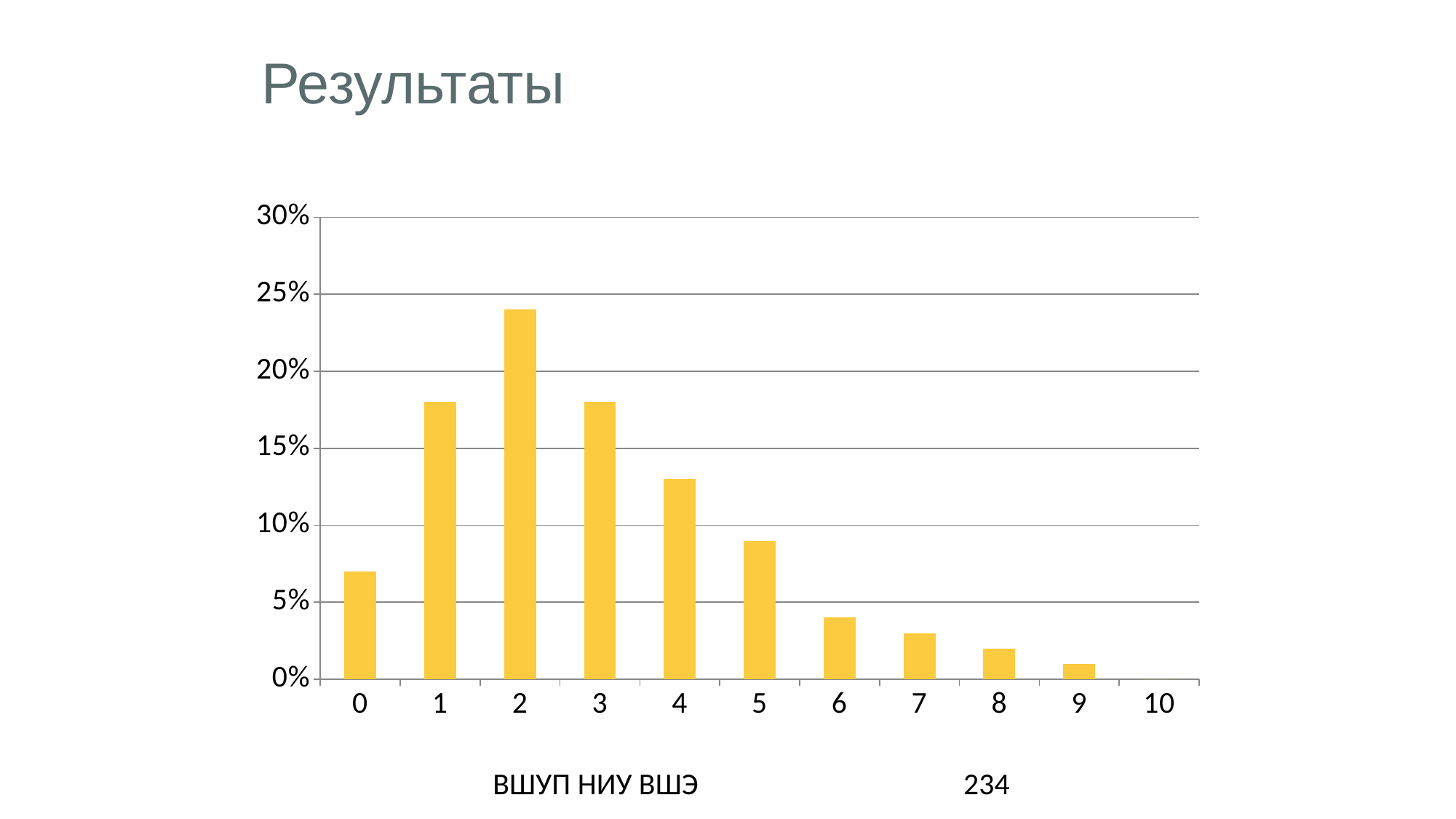
Is the value for category 5 greater or less than 10%? less Is the value for category 2 greater or less than 20%? greater Which category has the highest bar? 2 Which category on the x axis has no visible bar? 10 What kind of chart is shown on the slide? bar chart Is the value for category 0 greater or less than 5%? greater Do the values rise or fall from category 2 to category 9? fall What is the title of the slide? Результаты How many categories are labelled on the x axis? 11 Which is larger, the value for category 4 or the value for category 5? 4